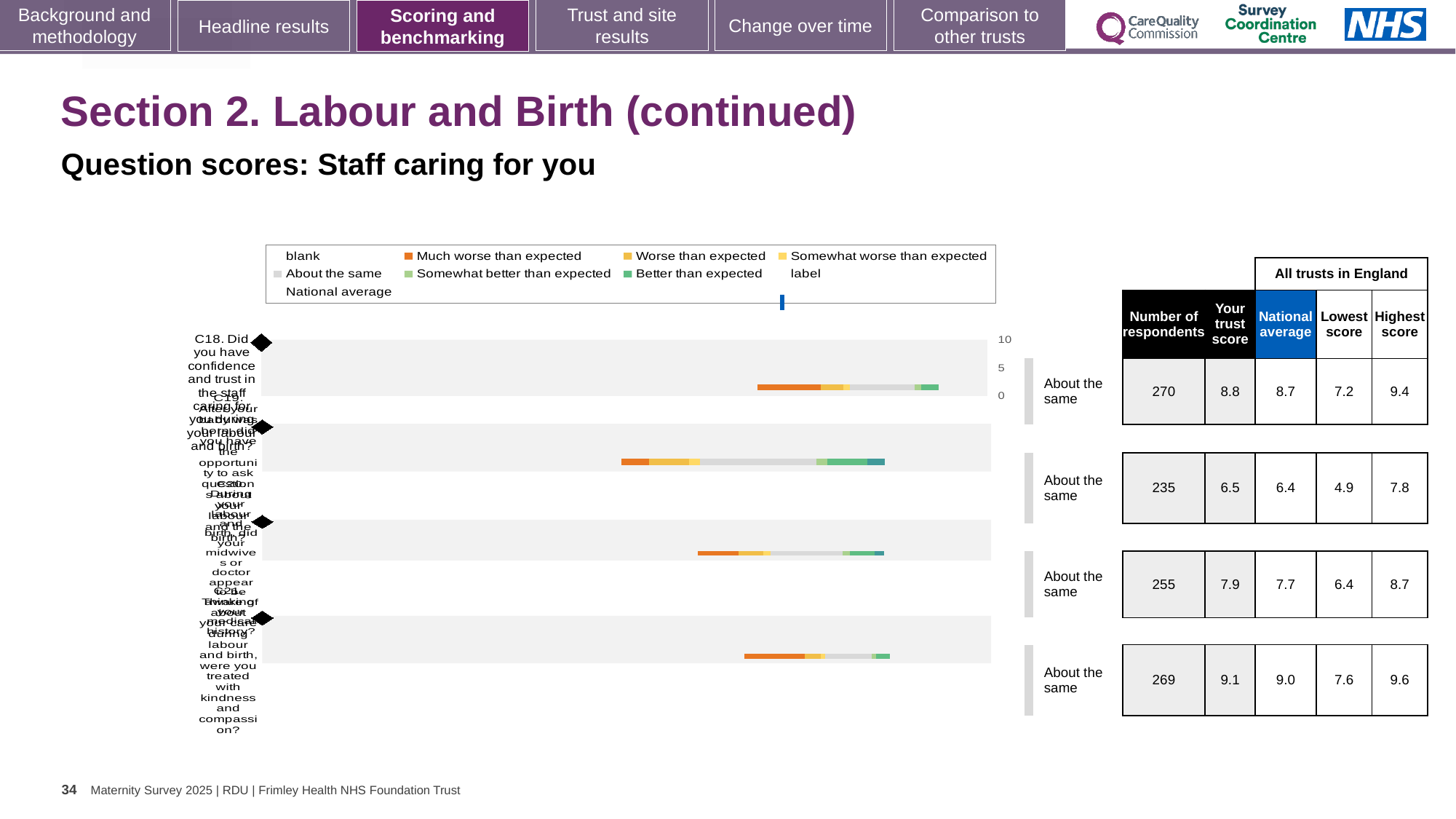
For question C20, which is larger: the trust score or the national average? trust score What is the difference between the trust score and the national average for question C18? 0.1 What colour represents 'Much worse than expected' in the chart legend? orange What kind of chart is shown on the slide? bar chart In the table beside the chart, what is the trust score for question C18? 8.8 Which question has the highest trust score in the table beside the chart? C21 In the table beside the chart, what is the highest score for question C21? 9.6 Which question has the lowest trust score in the table beside the chart? C19 What is the subtitle describing the chart's content? Question scores: Staff caring for you How many questions (bars) are plotted in the chart? 4 In the table beside the chart, what is the number of respondents for question C19? 235 In the table beside the chart, what is the national average for question C20? 7.7